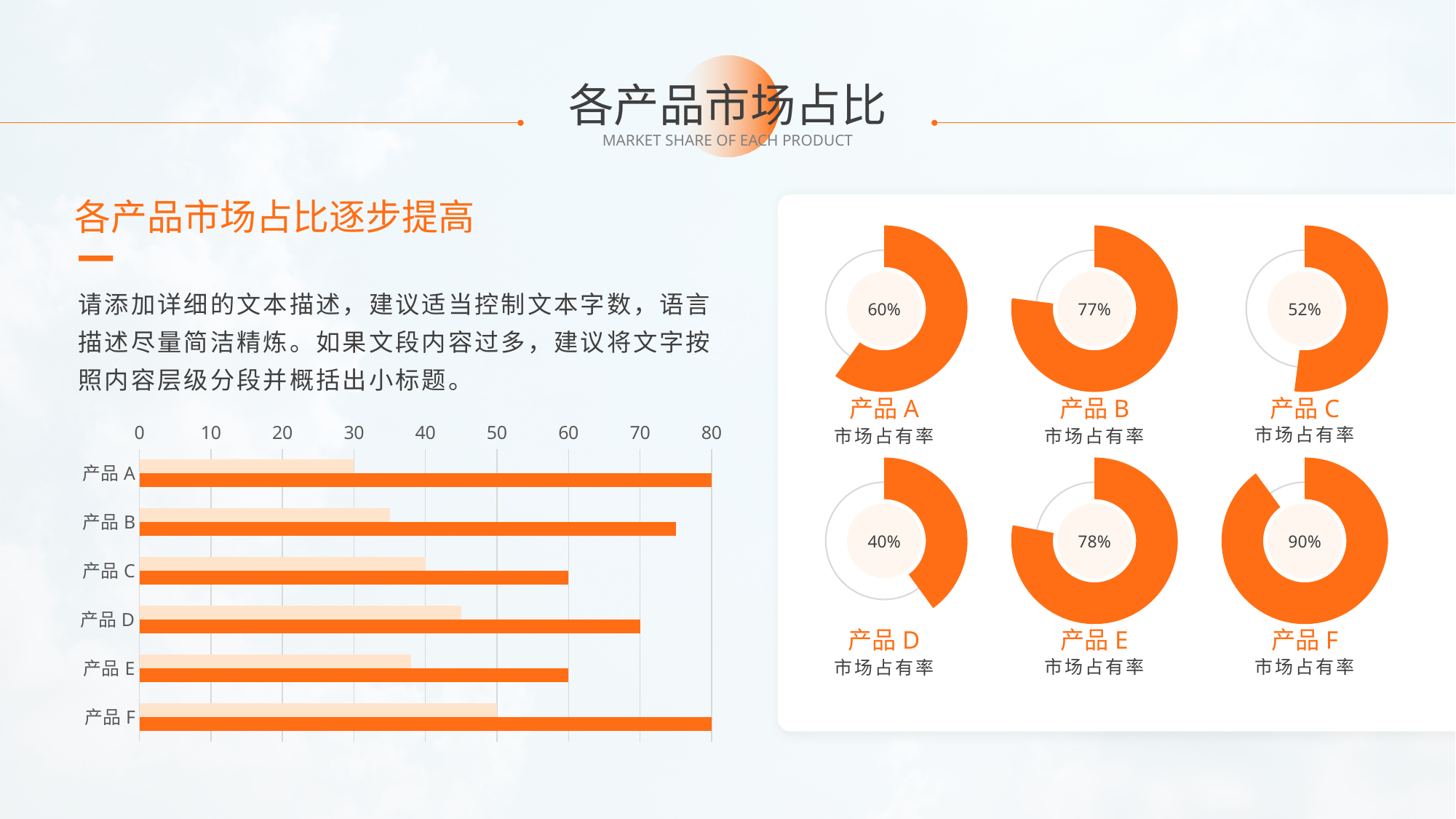
In the donut charts on the right, which product has the highest market share? 产品 F In the donut charts on the right, which is larger, the market share of 产品 B or 产品 D? 产品 B How many donut charts are shown on the right side of the slide? 6 How many categories does the bar chart on the left show? 6 In the bar chart on the left, is the dark orange bar for 产品 C greater or less than 70? less In the donut charts on the right, what is the market share shown for 产品 A? 60% What is the highest value shown on the axis of the bar chart on the left? 80 In the bar chart on the left, is the light orange bar for 产品 F greater or less than 40? greater What kind of chart is shown on the left side of the slide? Bar chart In the donut charts on the right, what is the market share shown for 产品 E? 78% In the donut charts on the right, what is the difference between the market share of 产品 F and 产品 C? 38% In the donut charts on the right, which product has the lowest market share? 产品 D